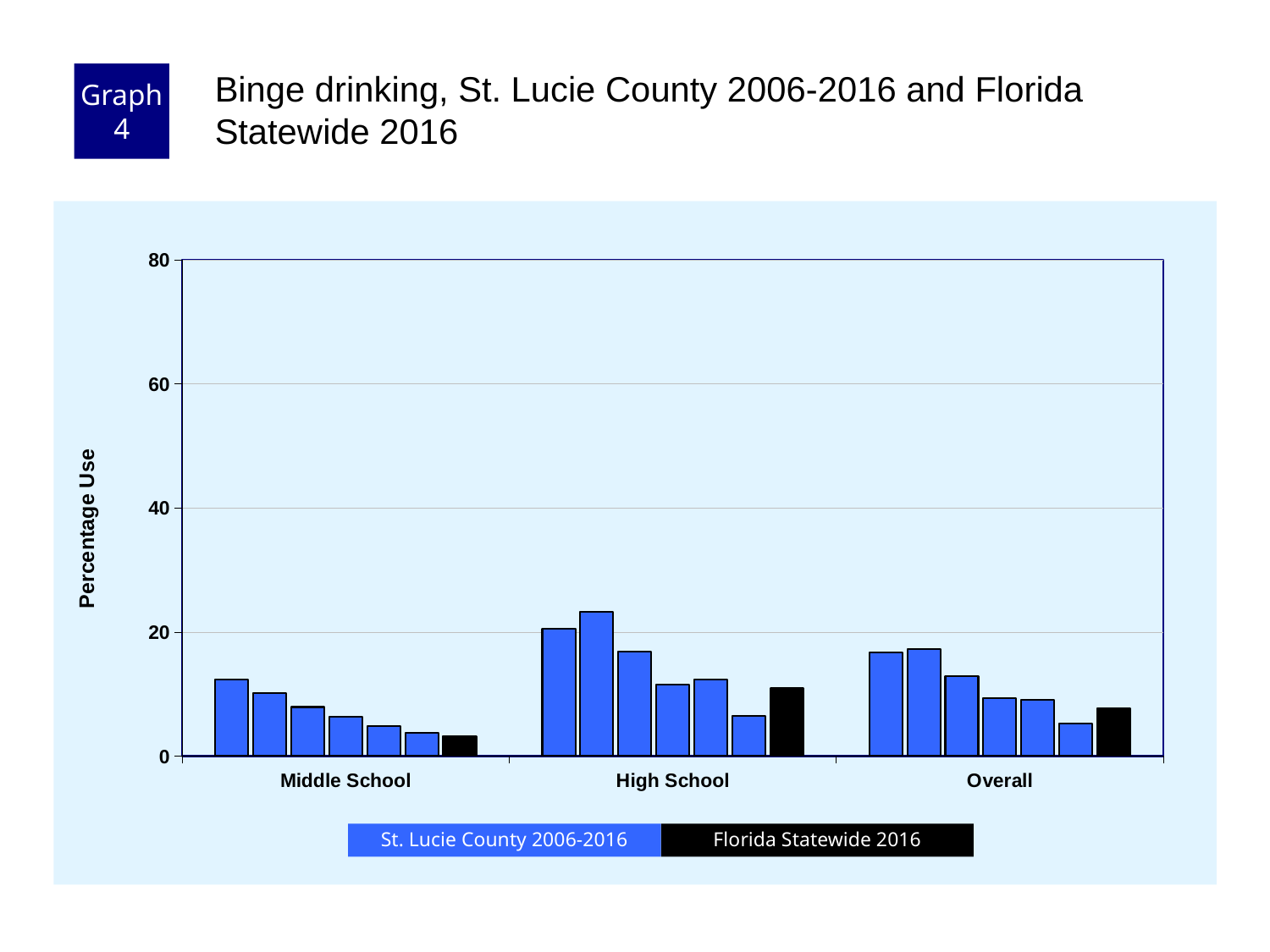
How many categories are shown on the x axis? 3 How many series does the legend list? 2 Within the Middle School group, do the St. Lucie County 2006-2016 bars rise or fall from left to right? fall Is the Florida Statewide 2016 bar for Overall larger or smaller than the Florida Statewide 2016 bar for High School? smaller Which colour represents Florida Statewide 2016 in the legend? black Is the tallest bar in the High School group greater or less than 40? less What is the label of the y axis? Percentage Use What kind of chart is shown on the slide? bar chart Is the Florida Statewide 2016 bar for High School larger or smaller than the Florida Statewide 2016 bar for Middle School? larger Is the Florida Statewide 2016 bar for Middle School greater or less than 20? less Which category contains the tallest bar? High School Which category contains the shortest bar? Middle School